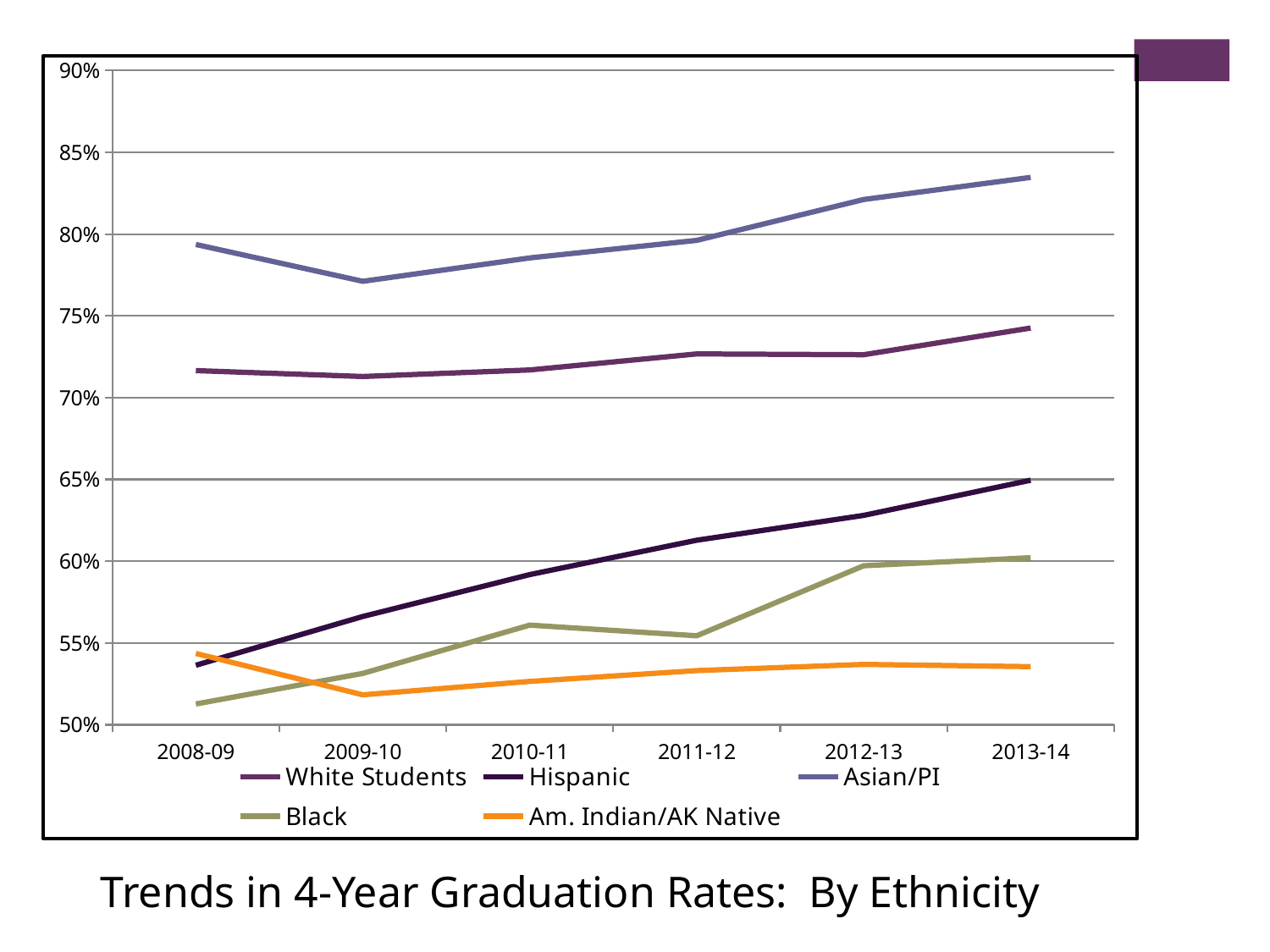
In 2013-14, which is larger: the Hispanic rate or the Black rate? Hispanic Which series has the lowest graduation rate in 2013-14? Am. Indian/AK Native Does the Hispanic graduation rate rise or fall from 2008-09 to 2013-14? rise In 2013-14, which is larger: the Black rate or the Am. Indian/AK Native rate? Black Is the value for White Students in 2009-10 greater or less than 70%? greater What is the title shown below the chart? Trends in 4-Year Graduation Rates: By Ethnicity Which series has the highest graduation rate in 2013-14? Asian/PI Is the value for Asian/PI in 2013-14 greater or less than 80%? greater How many series does the legend list? 5 Is the value for Hispanic in 2008-09 greater or less than 55%? less How many school years are shown on the x axis? 6 What kind of chart is shown on the slide? line chart